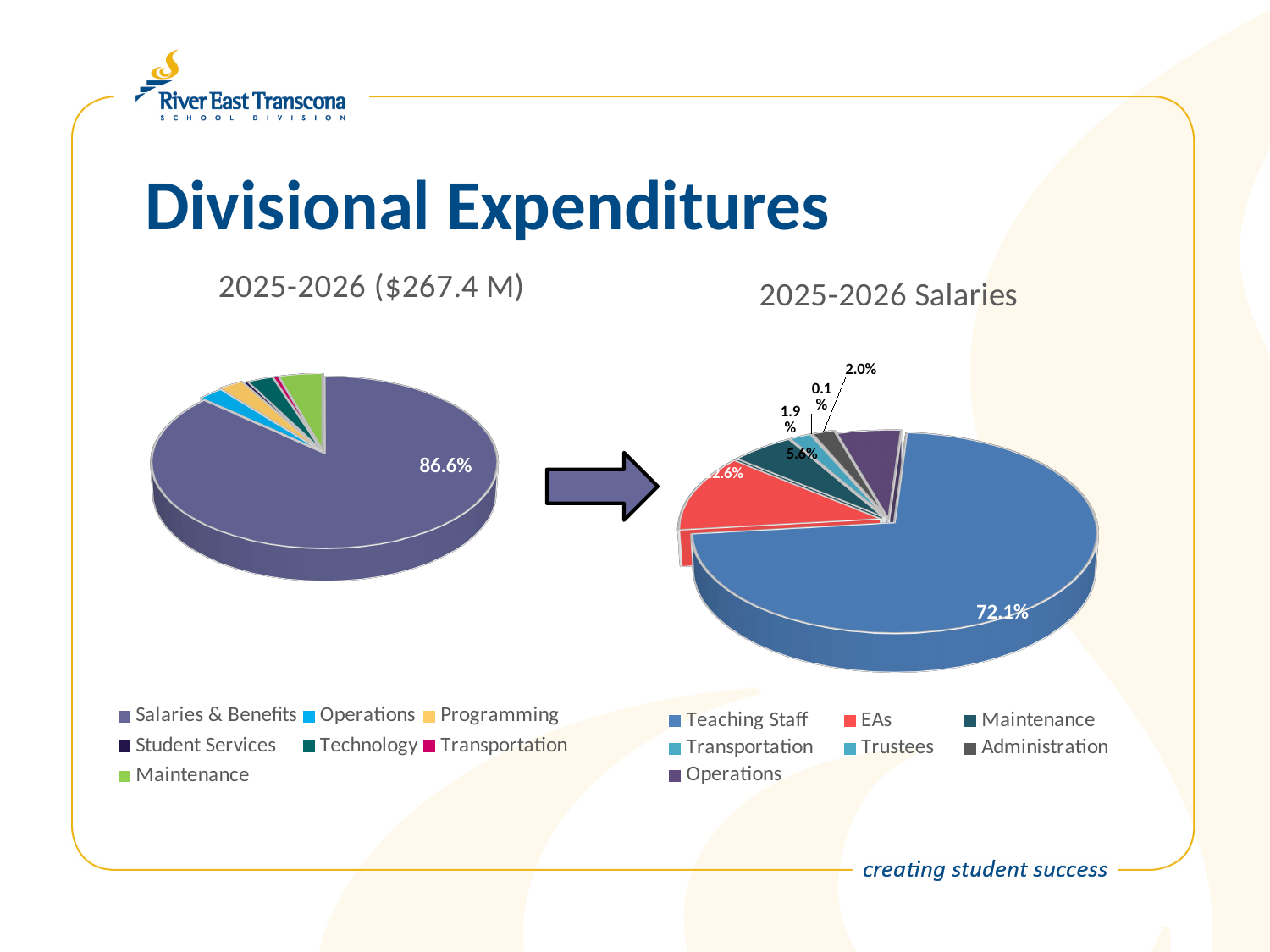
In the right chart titled "2025-2026 Salaries", which category has the smallest slice? Trustees In the right chart titled "2025-2026 Salaries", which category has the largest slice? Teaching Staff What is the title of the left pie chart? 2025-2026 ($267.4 M) How many categories does the legend of the left chart titled "2025-2026 ($267.4 M)" list? 7 In the left chart titled "2025-2026 ($267.4 M)", which category has the largest slice? Salaries & Benefits In the right chart titled "2025-2026 Salaries", what share is Maintenance? 5.6% In the right chart titled "2025-2026 Salaries", what share is Teaching Staff? 72.1% In the right chart titled "2025-2026 Salaries", what is the difference between the Teaching Staff share and the Maintenance share? 66.5% What kind of chart is the left chart titled "2025-2026 ($267.4 M)"? pie chart In the right chart titled "2025-2026 Salaries", what share is Trustees? 0.1% How many categories does the legend of the right chart titled "2025-2026 Salaries" list? 7